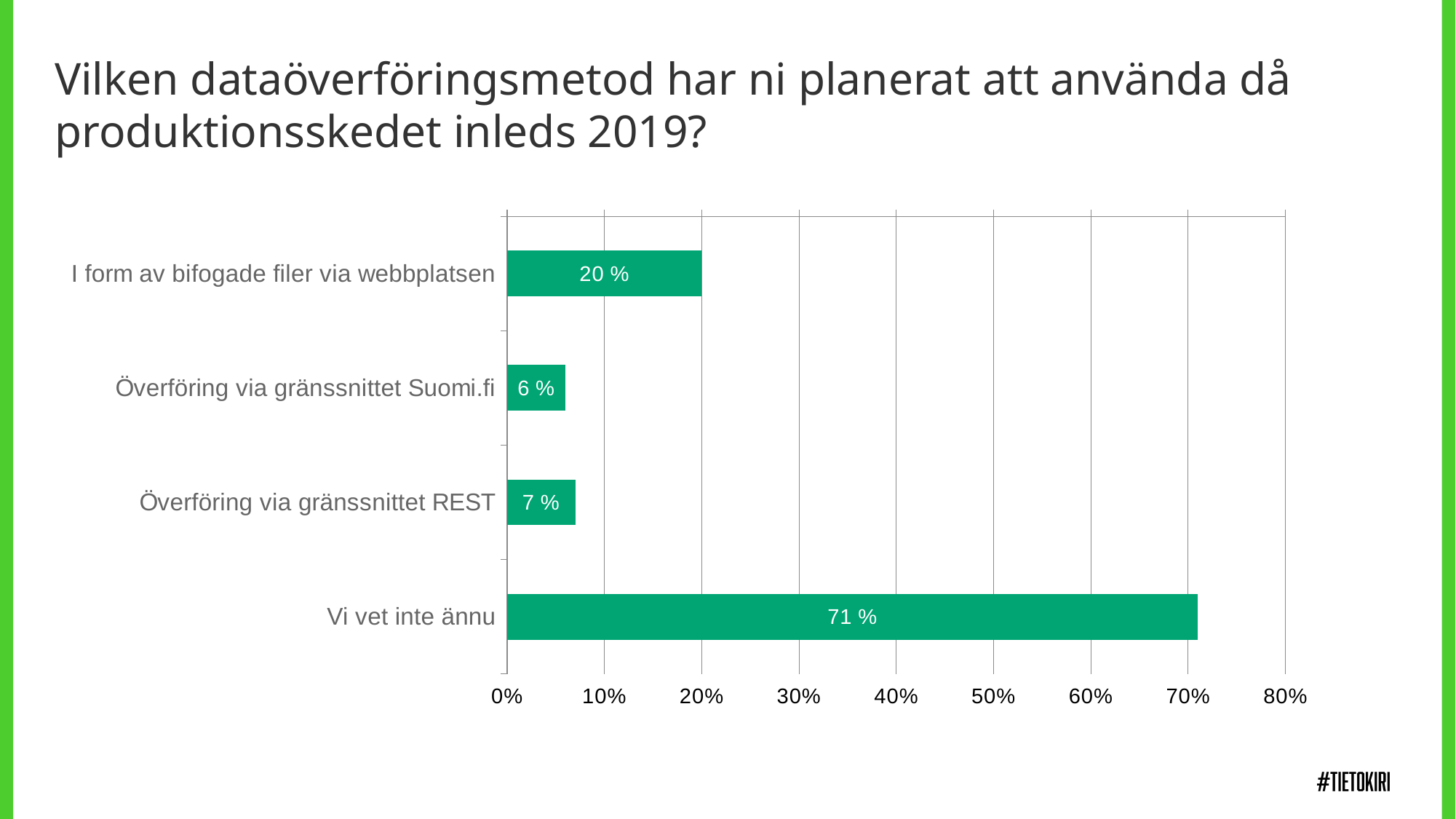
Which category has the lowest value? Överföring via gränssnittet Suomi.fi What is the value for "Överföring via gränssnittet REST"? 7 % What is the maximum value shown on the horizontal axis? 80% What is the value for "Vi vet inte ännu"? 71 % What kind of chart is shown on the slide? Bar chart What is the value for "Överföring via gränssnittet Suomi.fi"? 6 % How many categories are shown in the chart? 4 What is the value for "I form av bifogade filer via webbplatsen"? 20 % Is the value for "Vi vet inte ännu" greater or less than 60%? greater What is the difference between the values for "Vi vet inte ännu" and "I form av bifogade filer via webbplatsen"? 51 % Which category has the highest value? Vi vet inte ännu Which is larger: the value for "Överföring via gränssnittet REST" or "Överföring via gränssnittet Suomi.fi"? Överföring via gränssnittet REST